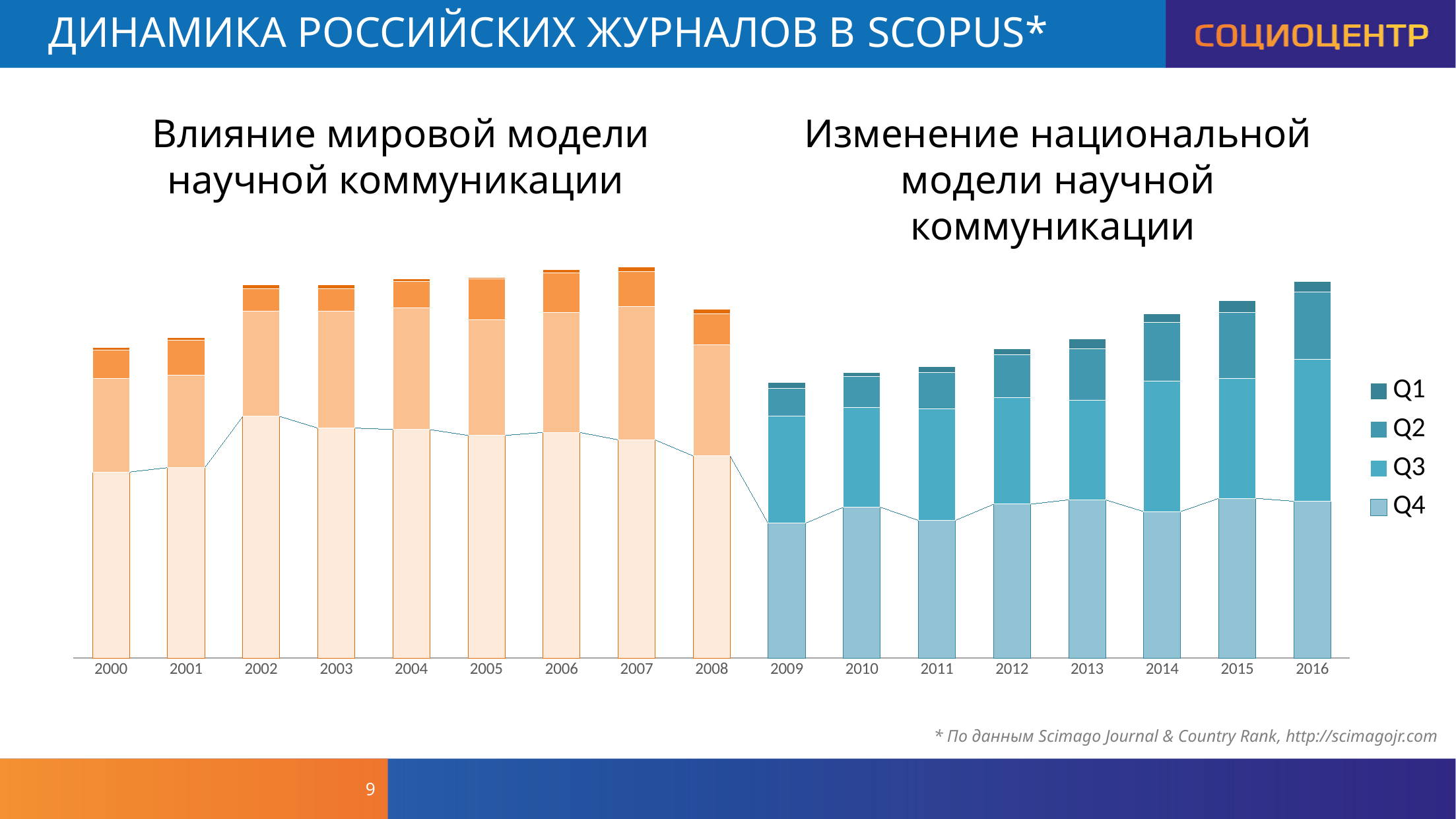
What is the title of the slide containing the chart? ДИНАМИКА РОССИЙСКИХ ЖУРНАЛОВ В SCOPUS* What is the first year shown on the x axis of the chart? 2000 Which year has the taller stacked bar, 2016 or 2009? 2016 What are the series names listed in the chart legend? Q1, Q2, Q3, Q4 What kind of chart is shown on the slide? Stacked bar chart Which year has the shortest stacked bar in the chart? 2009 Do the stacked bars rise or fall from 2000 to 2002? Rise How many years are shown along the x axis of the chart? 17 Which year has the taller stacked bar, 2002 or 2009? 2002 How many series does the chart legend list? 4 Which series forms the largest segment of the 2000 bar? Q4 Do the stacked bars rise or fall from 2009 to 2016? Rise